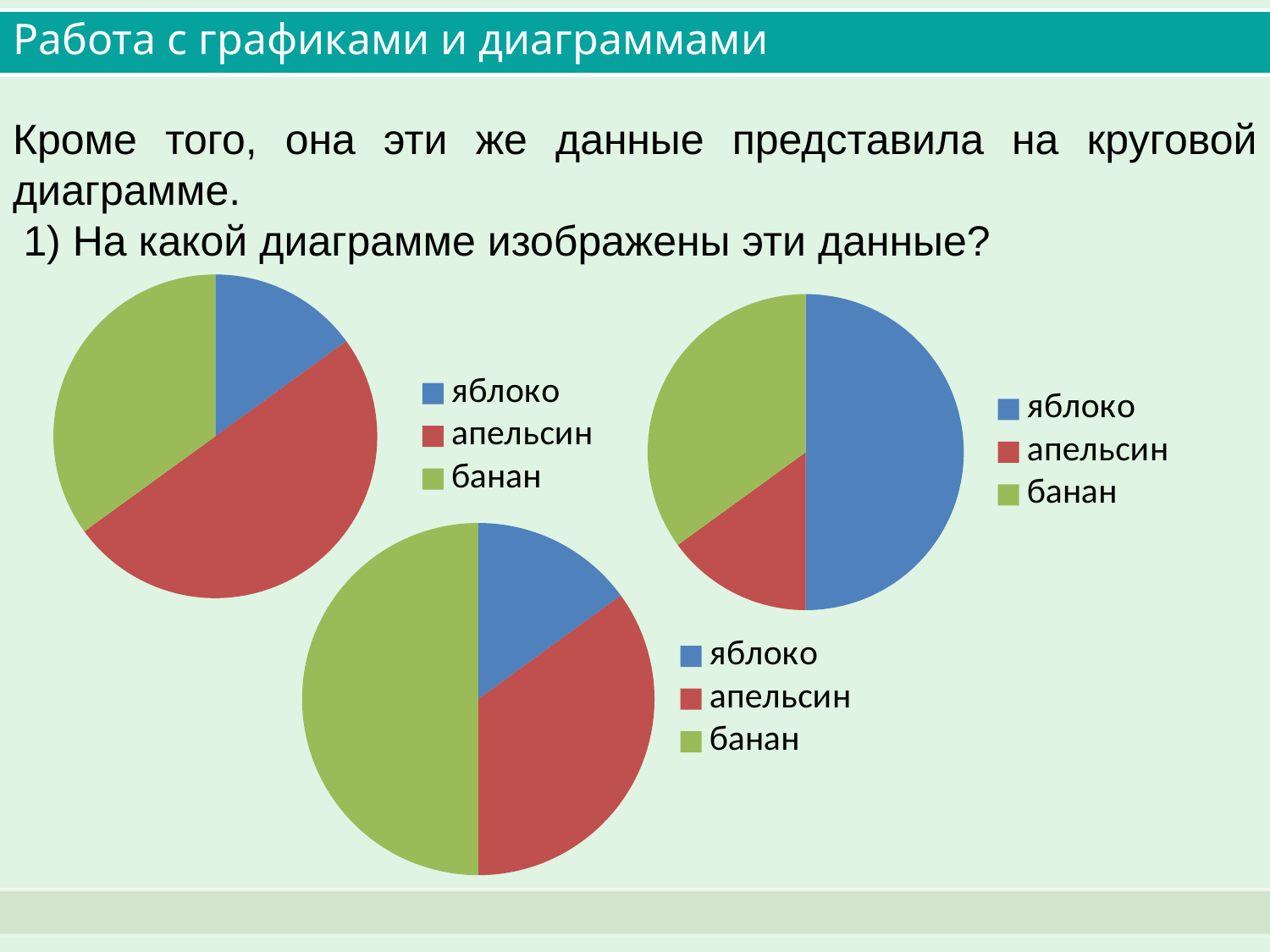
In the top-left pie chart, which category has the largest slice? апельсин What kind of chart is the top-left chart on the slide? pie chart In the top-right pie chart, which category has the largest slice? яблоко What colour represents банан in the legends of the pie charts? green In the bottom pie chart, which category has the smallest slice? яблоко In the top-left pie chart, which category has the smallest slice? яблоко In the bottom pie chart, which category has the largest slice? банан How many entries does the legend of the bottom pie chart list? 3 How many slices does the top-right pie chart have? 3 In the bottom pie chart, which slice is larger: апельсин or яблоко? апельсин In the top-right pie chart, which category has the smallest slice? апельсин In the top-right pie chart, which slice is larger: банан or апельсин? банан